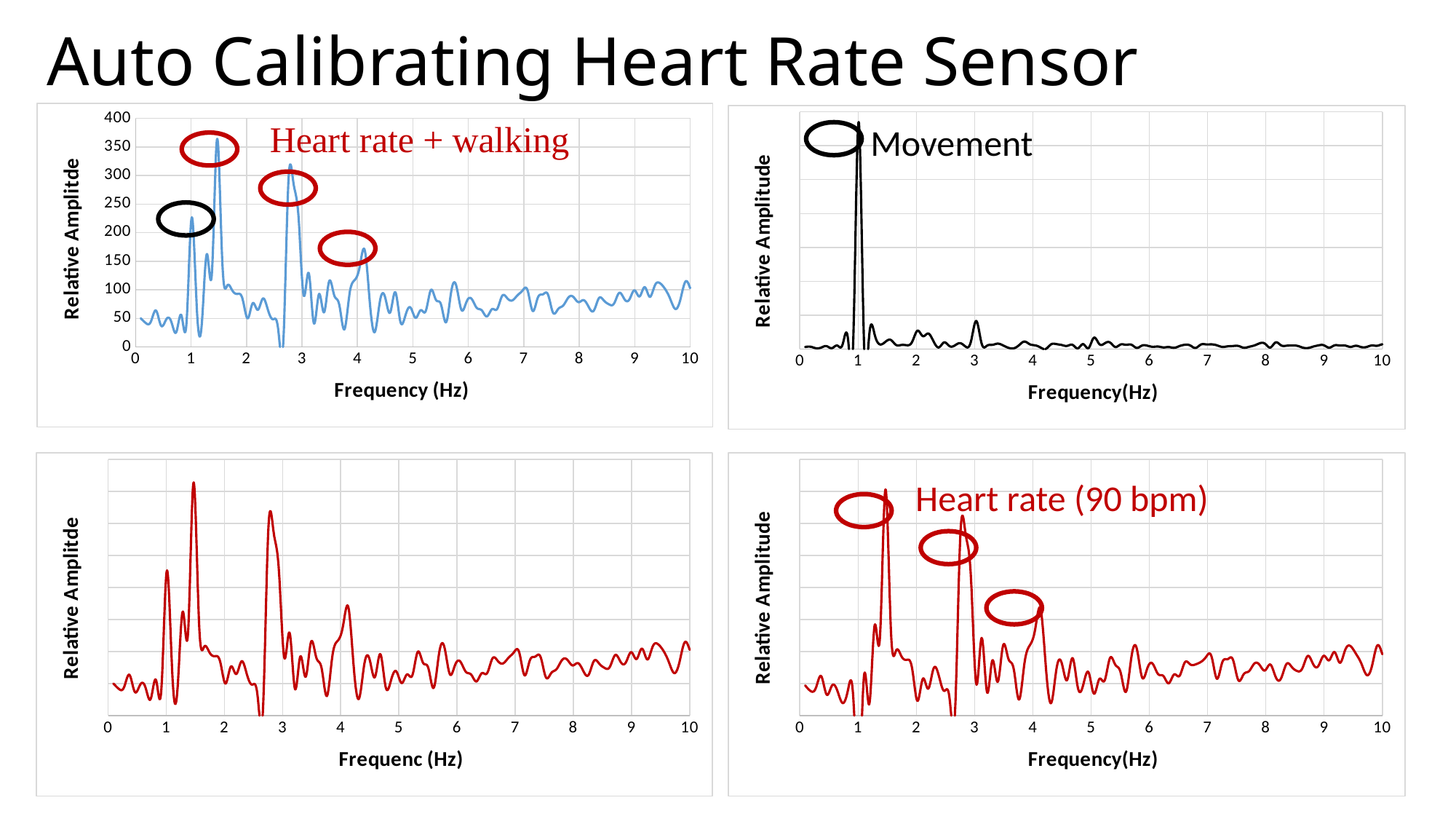
What is the x-axis title of the top-right chart? Frequency(Hz) What kind of chart is the top-left chart on the slide? line chart In the top-left chart, is the peak near 4 Hz (the rightmost red circle) greater or less than 150? greater In the top-left chart, is the peak near 1 Hz (circled in black) greater or less than 250? less In the top-left chart, which is higher: the peak near 1.5 Hz or the peak near 4 Hz? the peak near 1.5 Hz How many charts are shown on the slide? 4 In the top-left chart, is the peak near 4 Hz (the rightmost red circle) greater or less than 200? less What heart rate in bpm is annotated on the bottom-right chart? 90 bpm What is the maximum value shown on the y axis of the top-left chart? 400